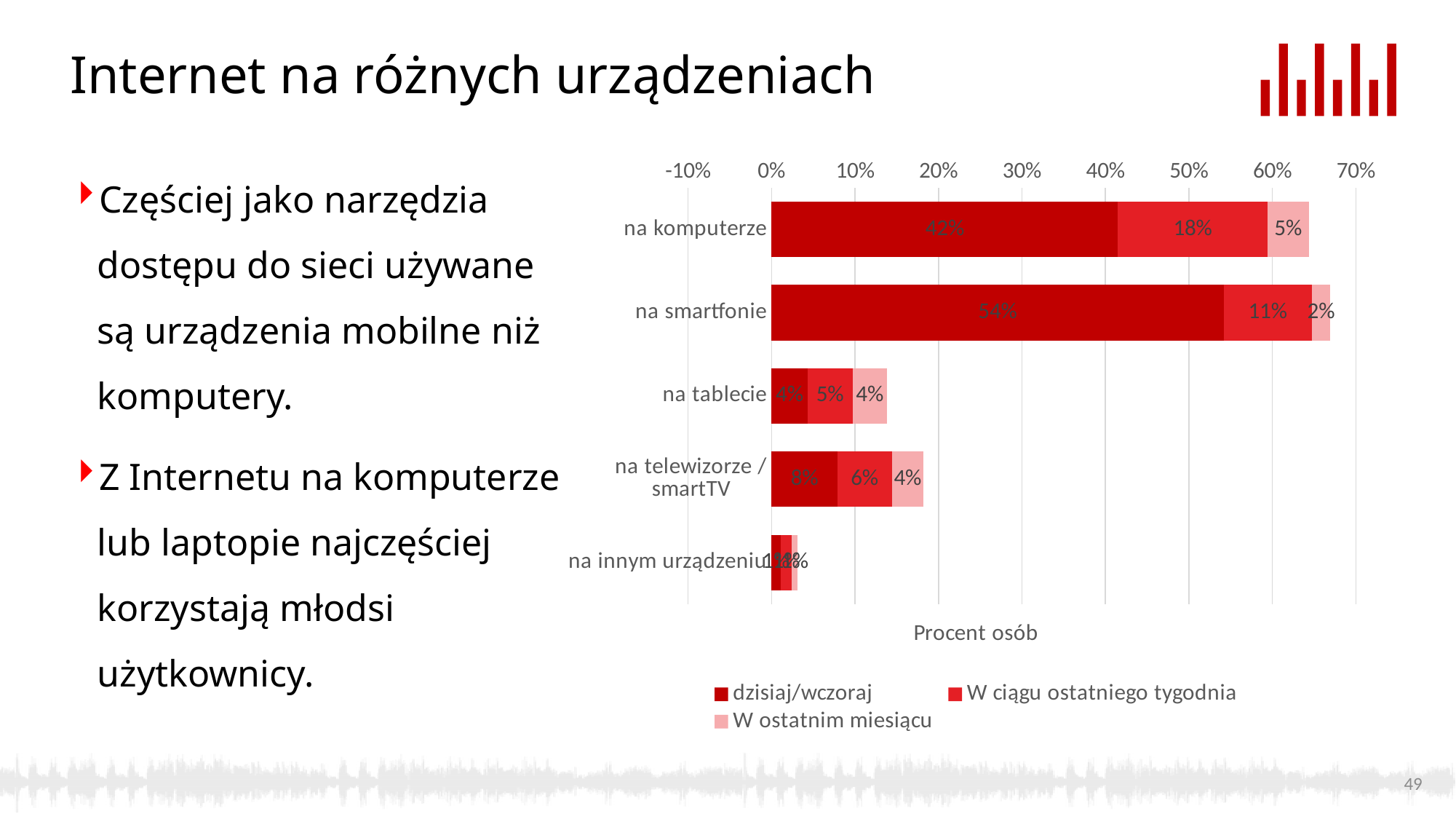
What is the value of the "W ostatnim miesiącu" series for "na tablecie"? 4% Which has the larger "W ciągu ostatniego tygodnia" value: "na komputerze" or "na smartfonie"? na komputerze What is the value of the "dzisiaj/wczoraj" series for "na komputerze"? 42% How many device categories are shown on the chart? 5 Which category has the shortest stacked bar overall? na innym urządzeniu What is the total of the stacked bar for "na komputerze"? 65% What is the difference between the "dzisiaj/wczoraj" values for "na smartfonie" and "na komputerze"? 12 percentage points How many series does the legend list? 3 What is the total of the stacked bar for "na telewizorze / smartTV"? 18% What is the value of the "W ciągu ostatniego tygodnia" series for "na smartfonie"? 11% Which category has the highest value for the "dzisiaj/wczoraj" series? na smartfonie What kind of chart is shown on the slide? Stacked bar chart